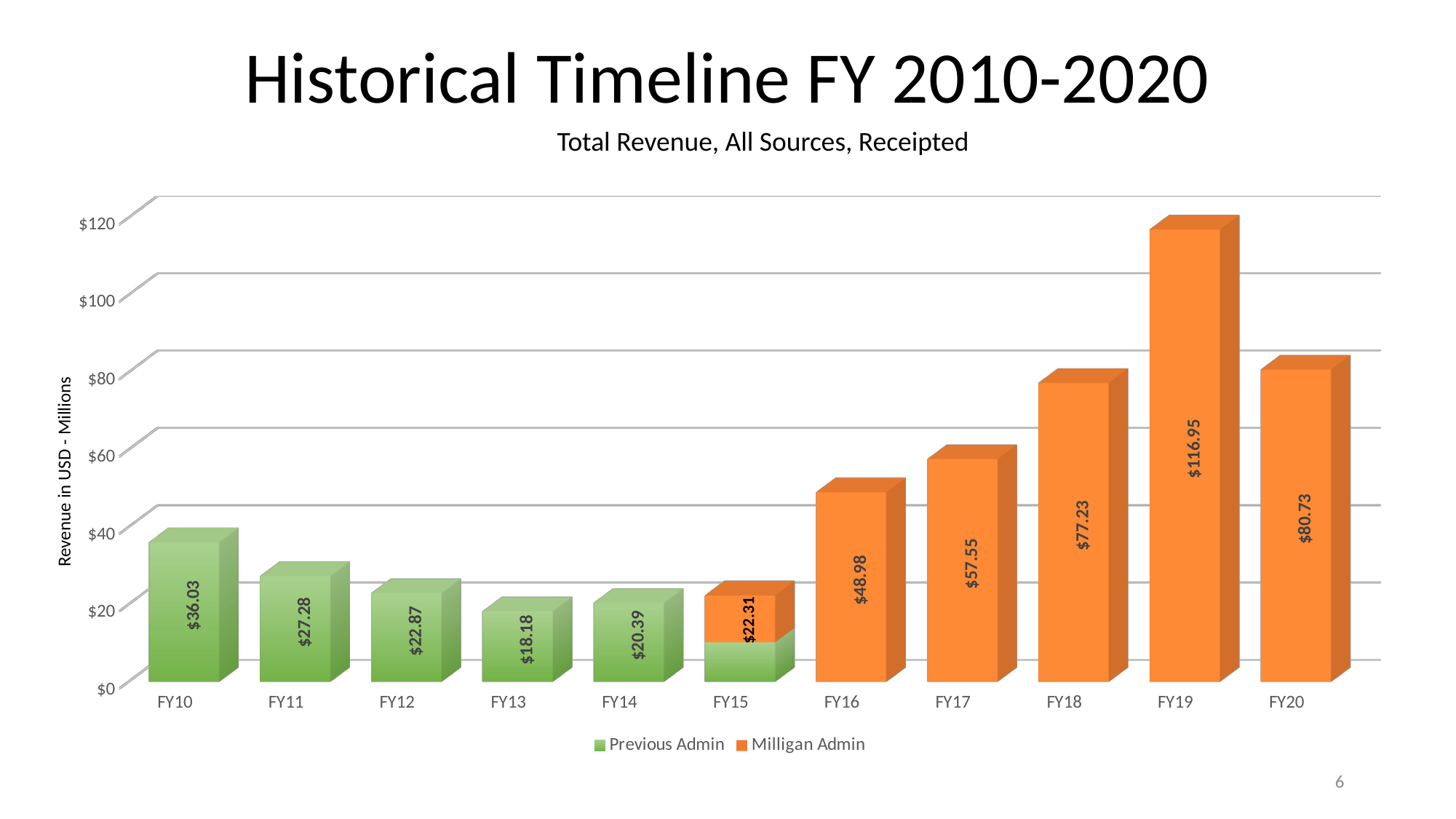
Which series is shown in orange according to the legend? Milligan Admin What is the difference between the FY19 and FY20 revenue values? $36.22 What is the total revenue value shown for FY19? $116.95 What is the revenue value labeled on the FY13 bar? $18.18 Which fiscal year has the highest total revenue? FY19 How many fiscal years are shown on the x axis? 11 Which is larger, the revenue for FY18 or for FY20? FY20 Is the value for FY19 greater or less than $100? greater Which fiscal year has the lowest total revenue? FY13 How many series does the legend list? 2 What kind of chart is shown on the slide? bar chart What is the revenue value shown for FY15? $22.31